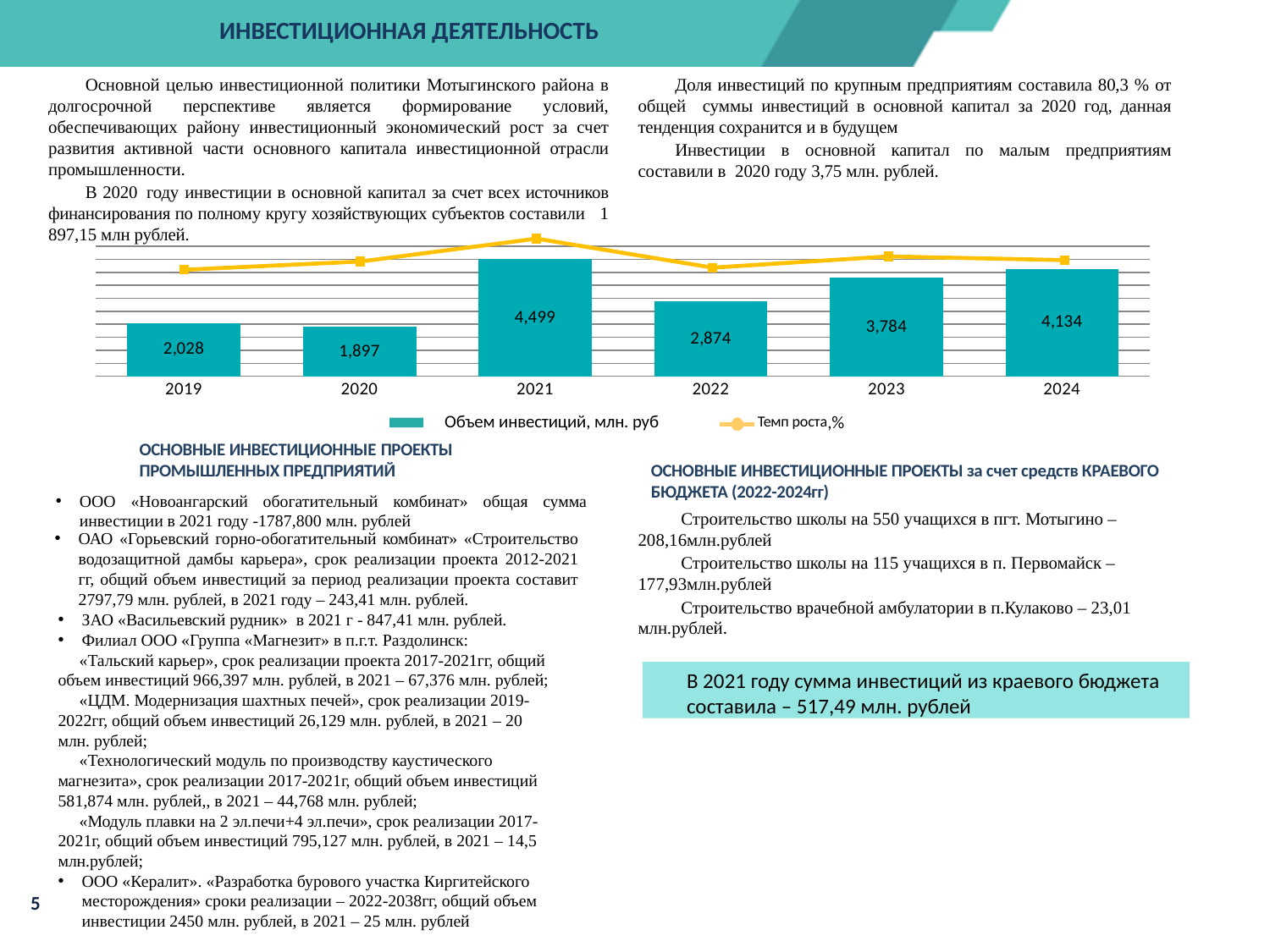
What is the value of Объем инвестиций, млн. руб for 2020? 1,897 Which is larger, the Объем инвестиций value for 2023 or for 2024? 2024 What is the value of Объем инвестиций, млн. руб for 2021? 4,499 Which year has the lowest value of Объем инвестиций, млн. руб? 2020 What kind of chart is used to show Объем инвестиций, млн. руб? bar chart What is the difference between the Объем инвестиций values for 2019 and 2020? 131 What is the value of Объем инвестиций, млн. руб for 2024? 4,134 How many series does the chart legend list? 2 Which series in the chart is drawn as a line? Темп роста,% What is the difference between the Объем инвестиций values for 2021 and 2022? 1,625 Which year has the highest value of Объем инвестиций, млн. руб? 2021 How many years are shown on the x axis of the chart? 6